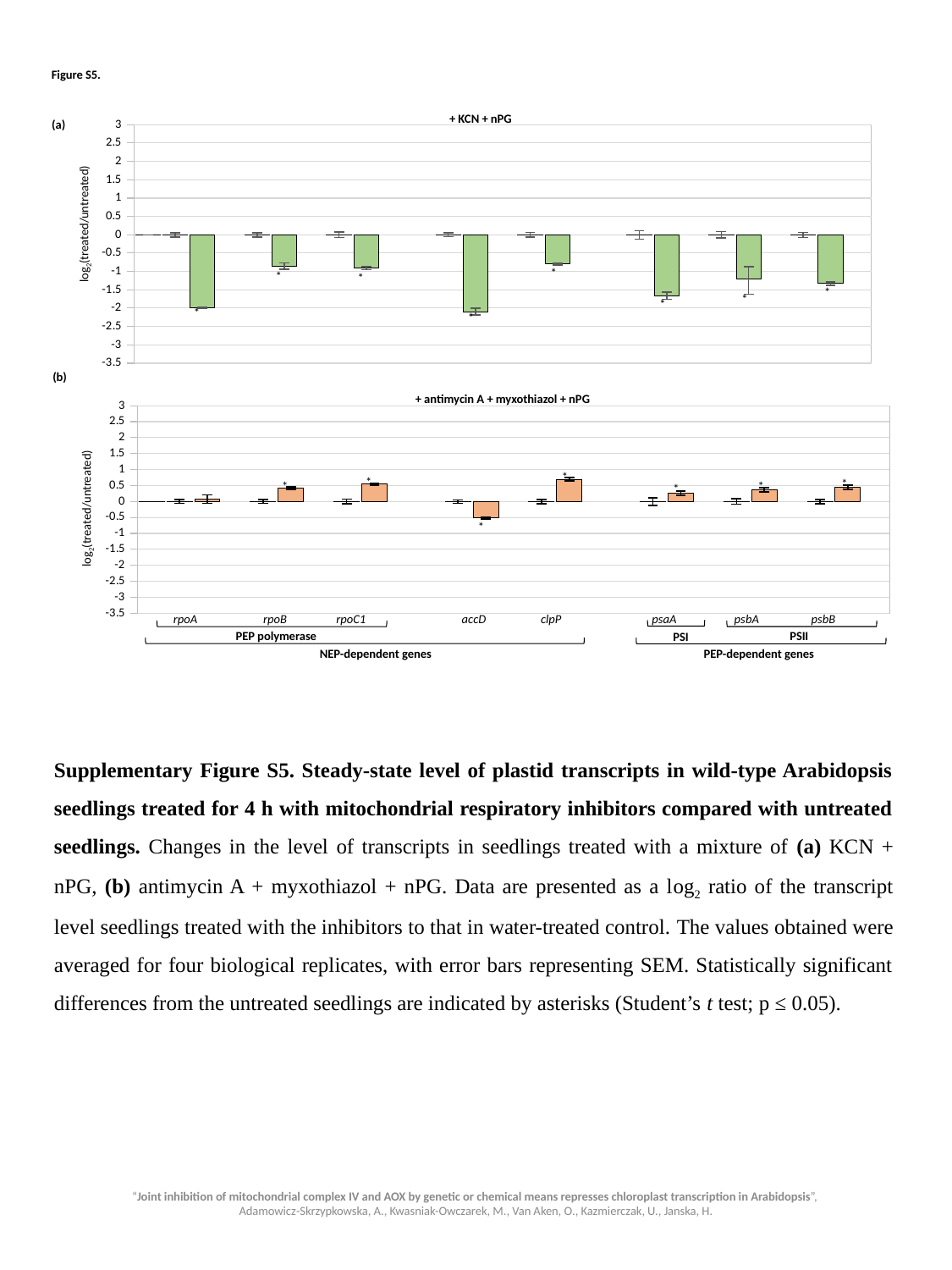
In the bottom chart titled "+ antimycin A + myxothiazol + nPG", which gene has the highest treated bar? clpP In the top chart titled "+ KCN + nPG", is the treated value for rpoB greater or less than -1? greater In the top chart titled "+ KCN + nPG", which has the larger treated value, rpoB or rpoA? rpoB In the top chart titled "+ KCN + nPG", is the treated value for rpoA greater or less than -1.5? less What is the y-axis label of the top chart titled "+ KCN + nPG"? log2(treated/untreated) In the top chart titled "+ KCN + nPG", is the treated value for accD greater or less than -1.5? less What is the title of the bottom chart labelled (b)? + antimycin A + myxothiazol + nPG In the bottom chart titled "+ antimycin A + myxothiazol + nPG", which has the larger treated value, clpP or rpoA? clpP How many genes are plotted along the x axis of the bottom chart titled "+ antimycin A + myxothiazol + nPG"? 8 In the bottom chart titled "+ antimycin A + myxothiazol + nPG", which gene has the lowest treated bar? accD What kind of chart is the top chart titled "+ KCN + nPG"? bar chart